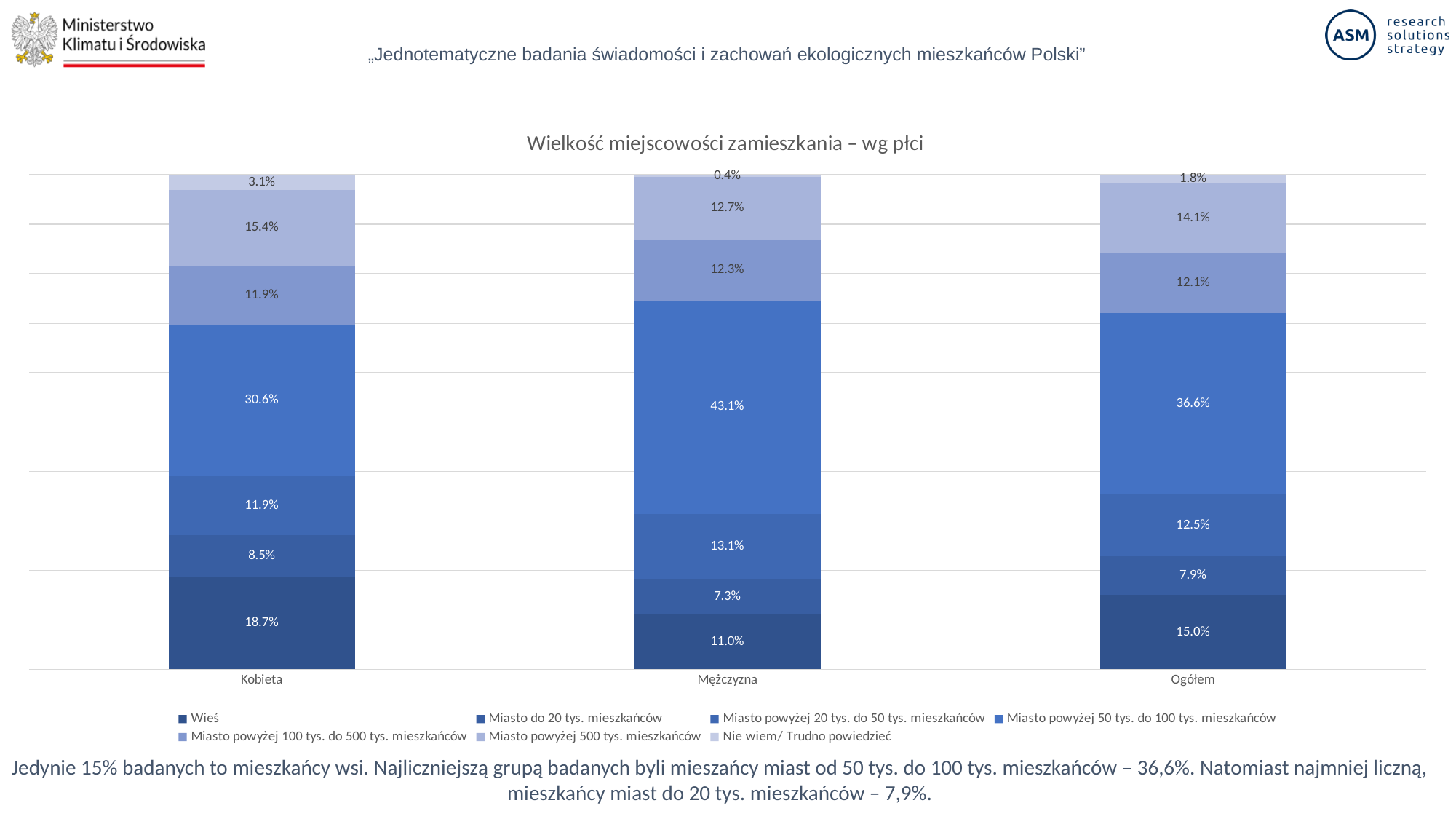
How many series does the legend list? 7 What is the title of the chart? Wielkość miejscowości zamieszkania – wg płci What is the value for Miasto powyżej 50 tys. do 100 tys. mieszkańców in the Mężczyzna bar? 43.1% Which is larger: the Miasto powyżej 500 tys. mieszkańców value for Kobieta or for Mężczyzna? Kobieta Which category has the lowest value for Wieś? Mężczyzna What is the value for Wieś in the Kobieta bar? 18.7% What type of chart is shown on the slide? stacked bar chart What is the value for Nie wiem/ Trudno powiedzieć in the Ogółem bar? 1.8% What is the difference between the Wieś values for Kobieta and Mężczyzna? 7.7% Which category has the highest value for Miasto powyżej 50 tys. do 100 tys. mieszkańców? Mężczyzna What is the value for Miasto do 20 tys. mieszkańców in the Mężczyzna bar? 7.3% How many categories are shown on the x axis? 3